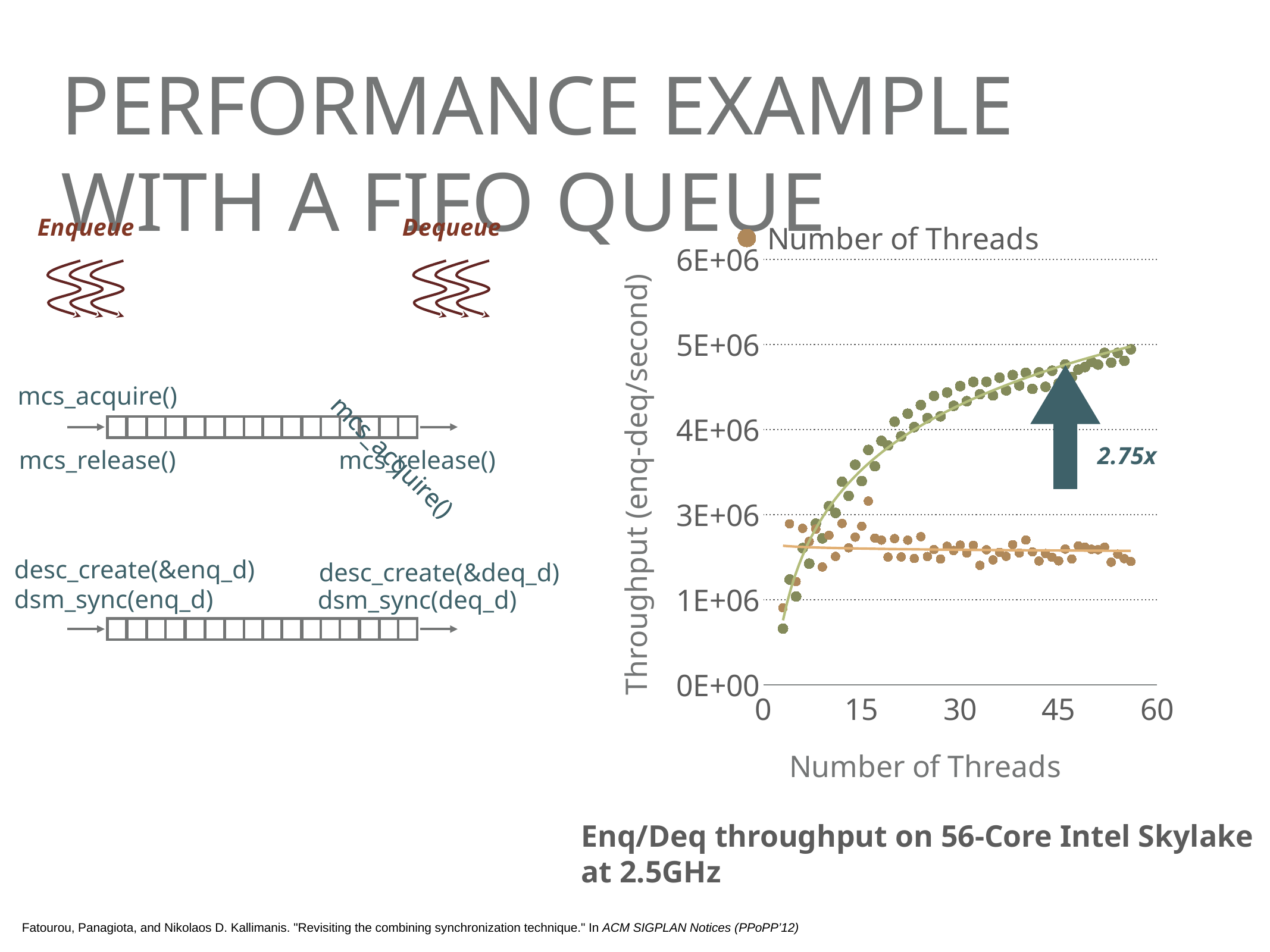
Is the value of the orange series at around 30 threads greater or less than 1E+06? greater What is the label of the y axis of the chart? Throughput (enq-deq/second) Is the value of the green series at around 55 threads greater or less than 4E+06? greater Does the green series rise or fall as the number of threads increases? rise What is the highest value shown on the y axis of the chart? 6E+06 What kind of chart is shown on the slide? scatter chart Is the value of the orange series at around 45 threads greater or less than 3E+06? less At around 50 threads, which series has the higher throughput, the green or the orange one? green What is the highest value shown on the x axis of the chart? 60